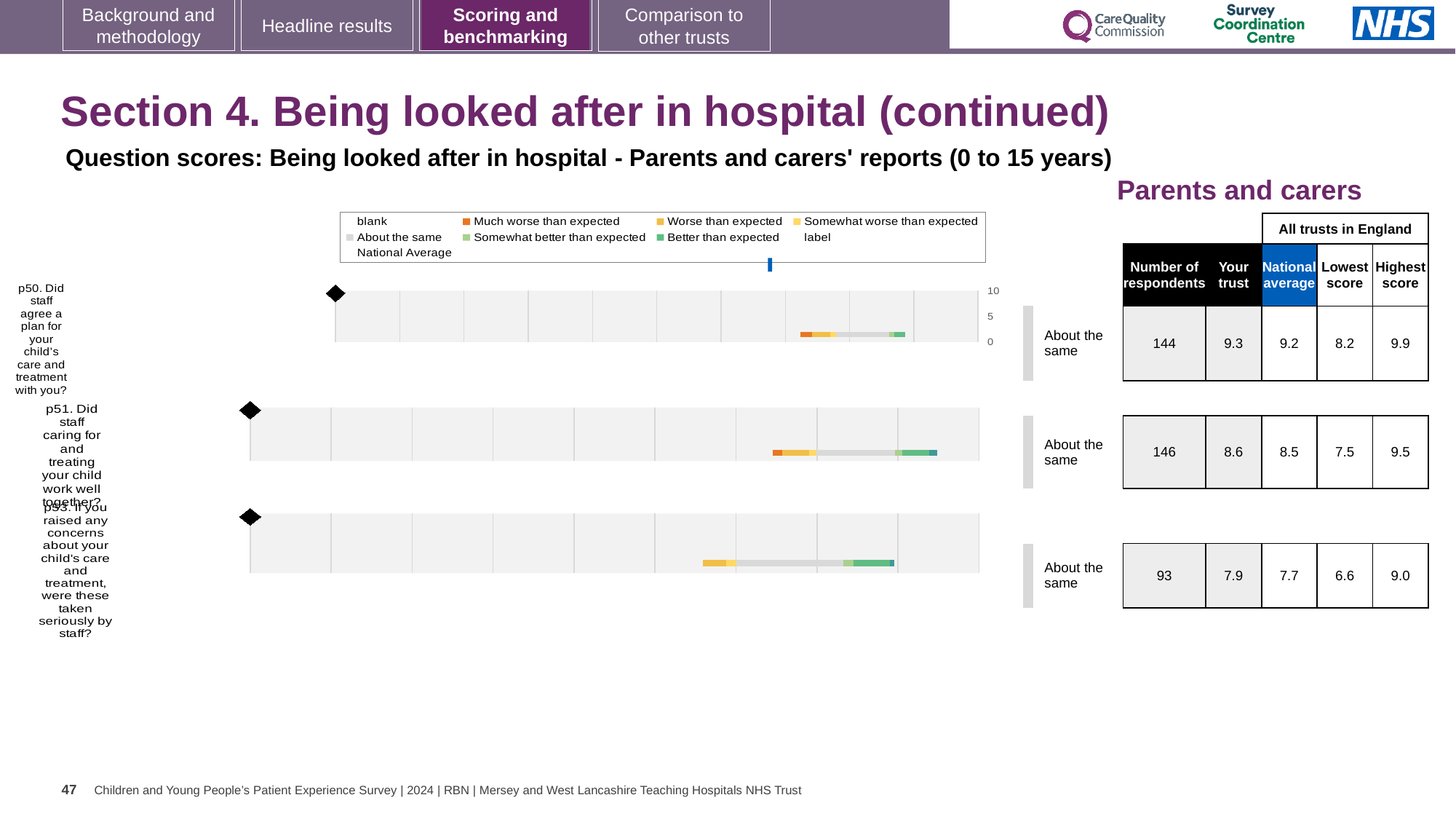
What is the 'Your trust' score for question p50 (Did staff agree a plan for your child's care and treatment with you?)? 9.3 How many questions are plotted in the charts on this slide? 3 Which of the three questions has the highest 'Your trust' score? p50 What benchmark category is shown for question p53? About the same What is the highest score across all trusts in England for question p50? 9.9 What is the lowest score across all trusts in England for question p53? 6.6 Which of the three questions has the fewest respondents? p53 How many respondents answered question p53 (If you raised any concerns about your child's care and treatment, were these taken seriously by staff?)? 93 What is the national average score for question p51 (Did staff caring for and treating your child work well together?)? 8.5 Is the 'Your trust' score for question p51 larger or smaller than the national average for that question? larger What kind of chart is used to show the question scores on this slide? bar chart What is the difference between the highest score (9.9) and the lowest score (8.2) for question p50? 1.7